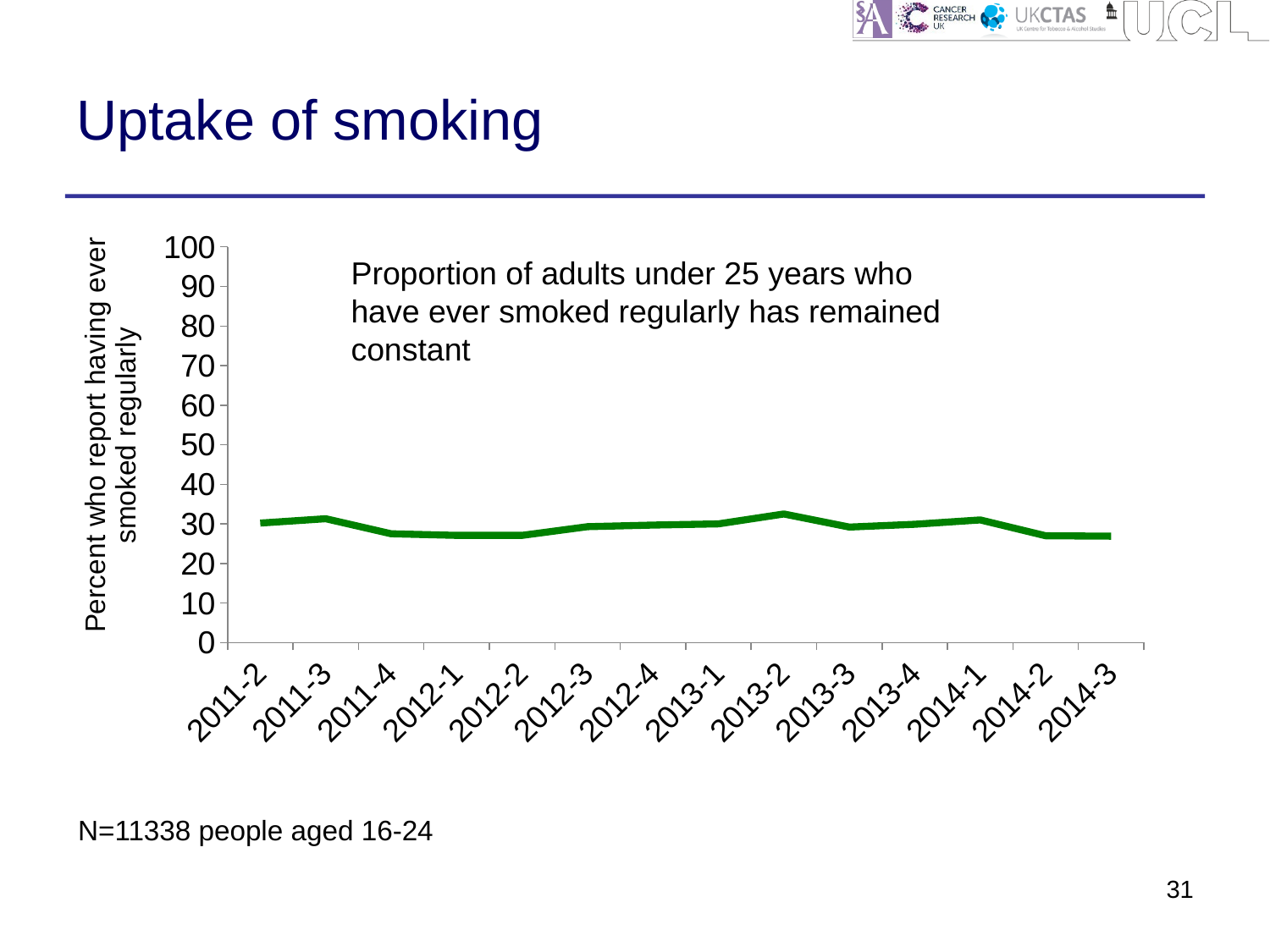
Is the value for 2013-2 greater or less than 40? less Is the value for 2012-2 greater or less than 20? greater What kind of chart is shown on the slide? line chart What is the title of the slide containing the chart? Uptake of smoking How many time points are plotted along the x axis? 14 Overall, does the line rise, fall, or stay roughly constant across the x axis? stays roughly constant Which is larger, the value for 2013-2 or the value for 2012-2? 2013-2 Which time point has the highest value on the line? 2013-2 What is the label on the y axis of the chart? Percent who report having ever smoked regularly What is the first time point shown on the x axis? 2011-2 Is the value for 2011-2 greater or less than 20? greater